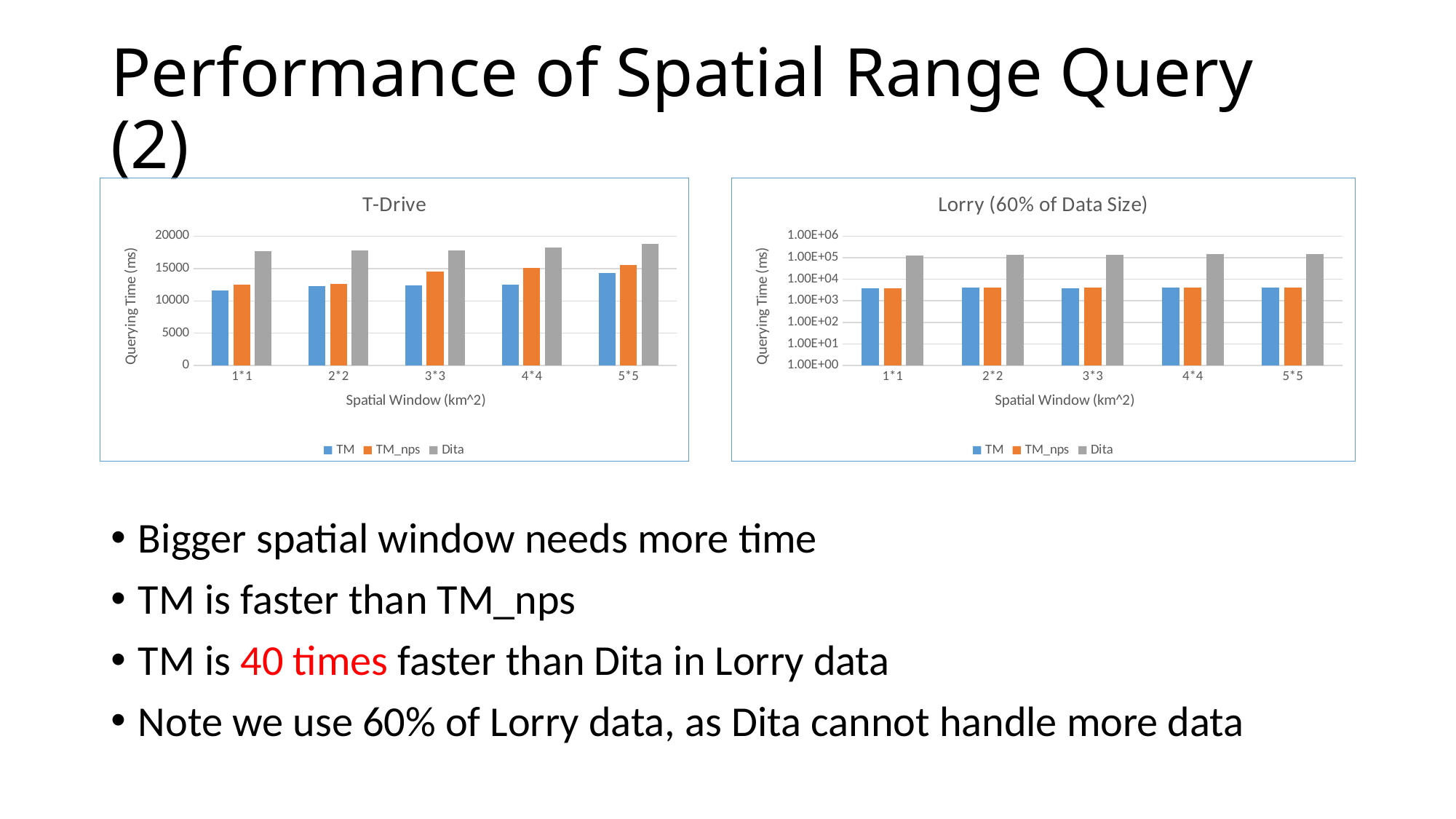
In the T-Drive chart, does the querying time for Dita rise or fall as the spatial window increases from 1*1 to 5*5? rise In the T-Drive chart, is the querying time for TM at spatial window 1*1 greater or less than 15000? less In the Lorry (60% of Data Size) chart, how many series does the legend list? 3 In the T-Drive chart, which series has the highest querying time at spatial window 5*5? Dita In the T-Drive chart, what kind of chart is shown? bar chart In the T-Drive chart, is the querying time for Dita at spatial window 5*5 greater or less than 15000? greater In the Lorry (60% of Data Size) chart, is the querying time for TM at spatial window 3*3 greater or less than 1.00E+04? less In the T-Drive chart, which series has the lowest querying time at spatial window 1*1? TM In the Lorry (60% of Data Size) chart, which is larger at spatial window 2*2: the querying time for Dita or for TM? Dita What is the title of the chart on the right of the slide? Lorry (60% of Data Size) In the T-Drive chart, how many spatial window categories are shown on the x axis? 5